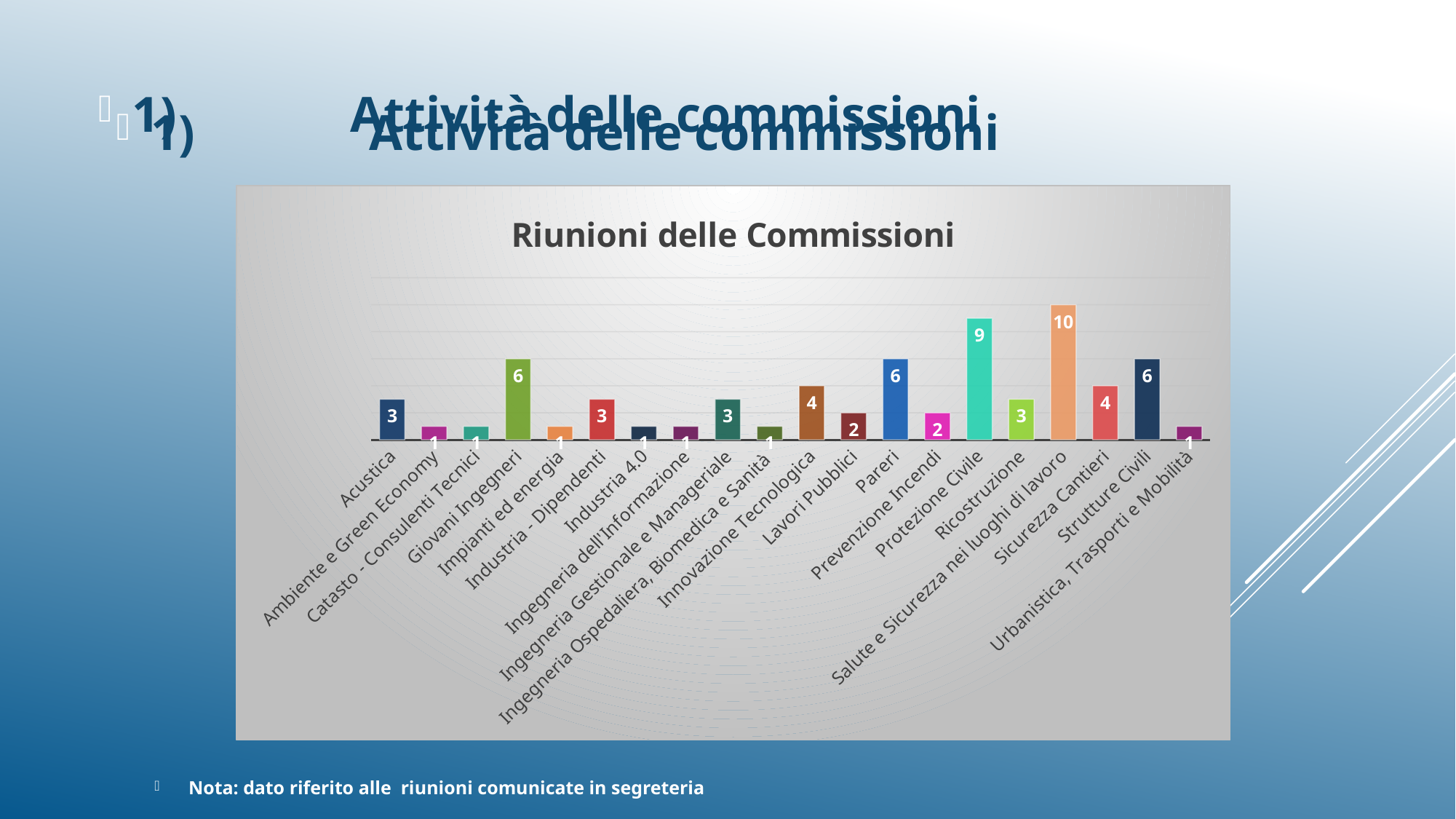
What is the value for Innovazione Tecnologica? 4 Which has a larger value, Ricostruzione or Prevenzione Incendi? Ricostruzione What is the difference between the values for Salute e Sicurezza nei luoghi di lavoro and Protezione Civile? 1 What is the value for Lavori Pubblici? 2 Which has a larger value, Pareri or Sicurezza Cantieri? Pareri How many meetings are shown for Protezione Civile? 9 How many commissions (categories) are shown in the chart? 20 What is the difference between the values for Giovani Ingegneri and Acustica? 3 What is the value for Salute e Sicurezza nei luoghi di lavoro? 10 Which commission has the highest number of meetings? Salute e Sicurezza nei luoghi di lavoro What is the title of the chart? Riunioni delle Commissioni What type of chart is shown on the slide? bar chart